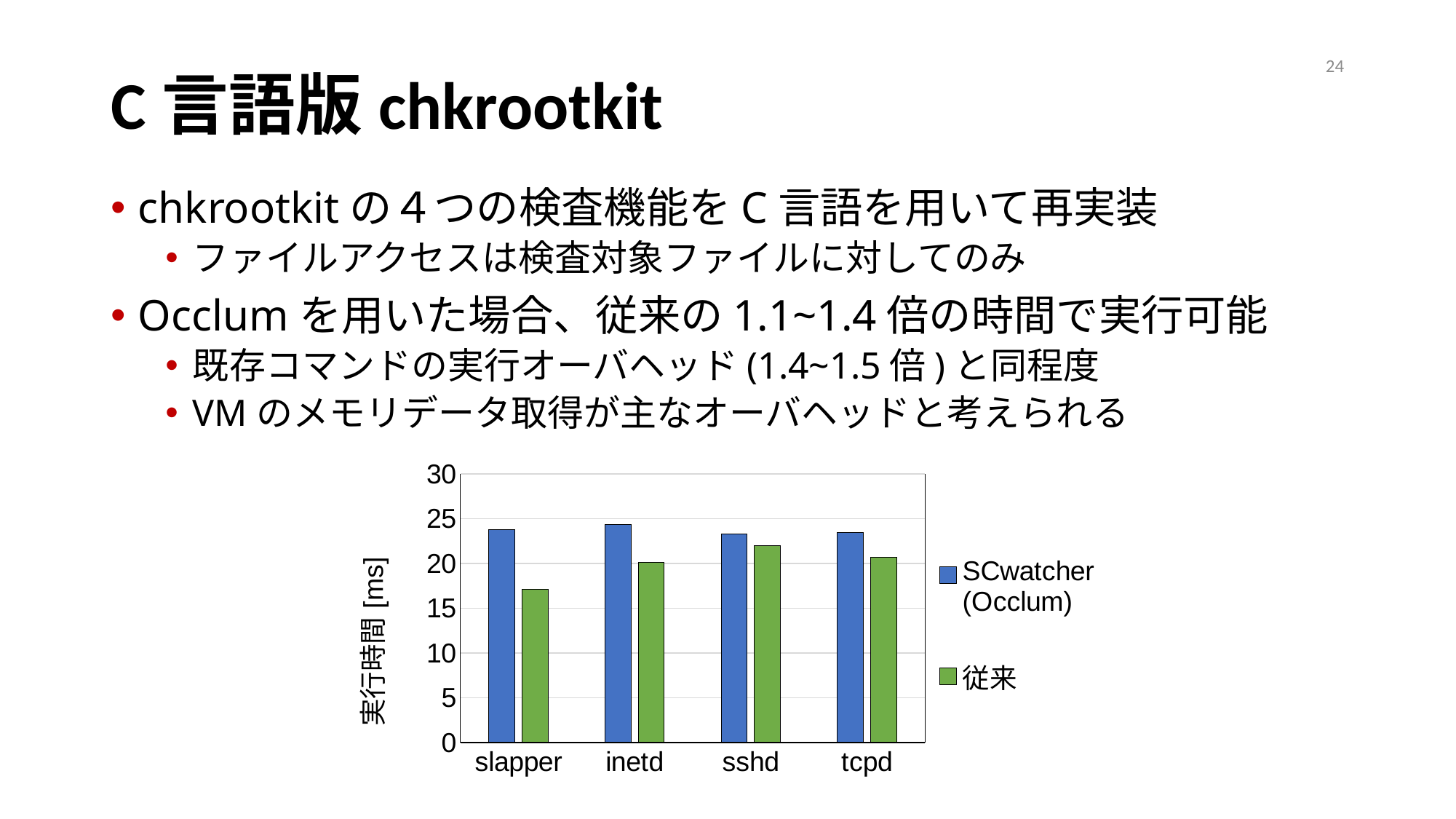
For slapper, which is larger: the SCwatcher (Occlum) value or the 従来 value? SCwatcher (Occlum) What kind of chart is shown on the slide? bar chart Is the SCwatcher (Occlum) value for tcpd greater or less than 25? less Is the SCwatcher (Occlum) value for inetd greater or less than 20? greater Is the 従来 value for slapper greater or less than 20? less How many categories are shown on the x axis of the chart? 4 What are the two series listed in the chart's legend? SCwatcher (Occlum) and 従来 For inetd, which is larger: the SCwatcher (Occlum) value or the 従来 value? SCwatcher (Occlum) Which category has the highest 従来 value? sshd How many series does the chart's legend list? 2 What is the label of the chart's y axis? 実行時間 [ms] Which category has the lowest 従来 value? slapper